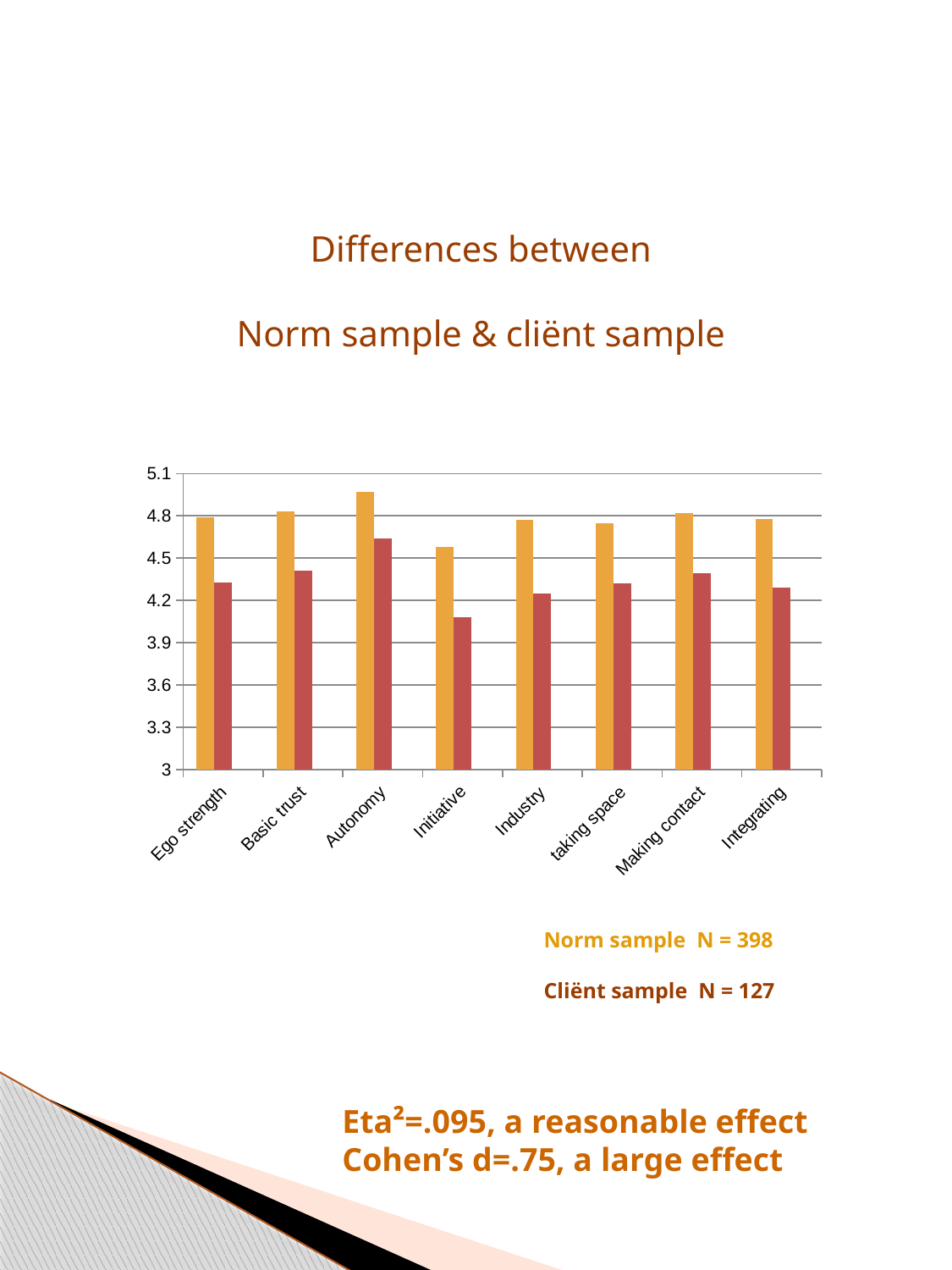
Which category has the highest value for the Cliënt sample (red bars)? Autonomy Is the Norm sample value for Autonomy greater or less than 4.8? greater Which category has the lowest value for the Norm sample (orange bars)? Initiative Which category has the lowest value for the Cliënt sample (red bars)? Initiative Is the Cliënt sample value for Initiative greater or less than 4.2? less What kind of chart is shown on the slide? bar chart Which category has the highest value for the Norm sample (orange bars)? Autonomy For Basic trust, which is larger: the Norm sample value or the Cliënt sample value? Norm sample Is the Cliënt sample value for Autonomy greater or less than 4.5? greater How many categories are shown on the x axis of the chart? 8 How many data series (samples) are plotted in the chart? 2 What is the sample size (N) of the Norm sample shown below the chart? N = 398